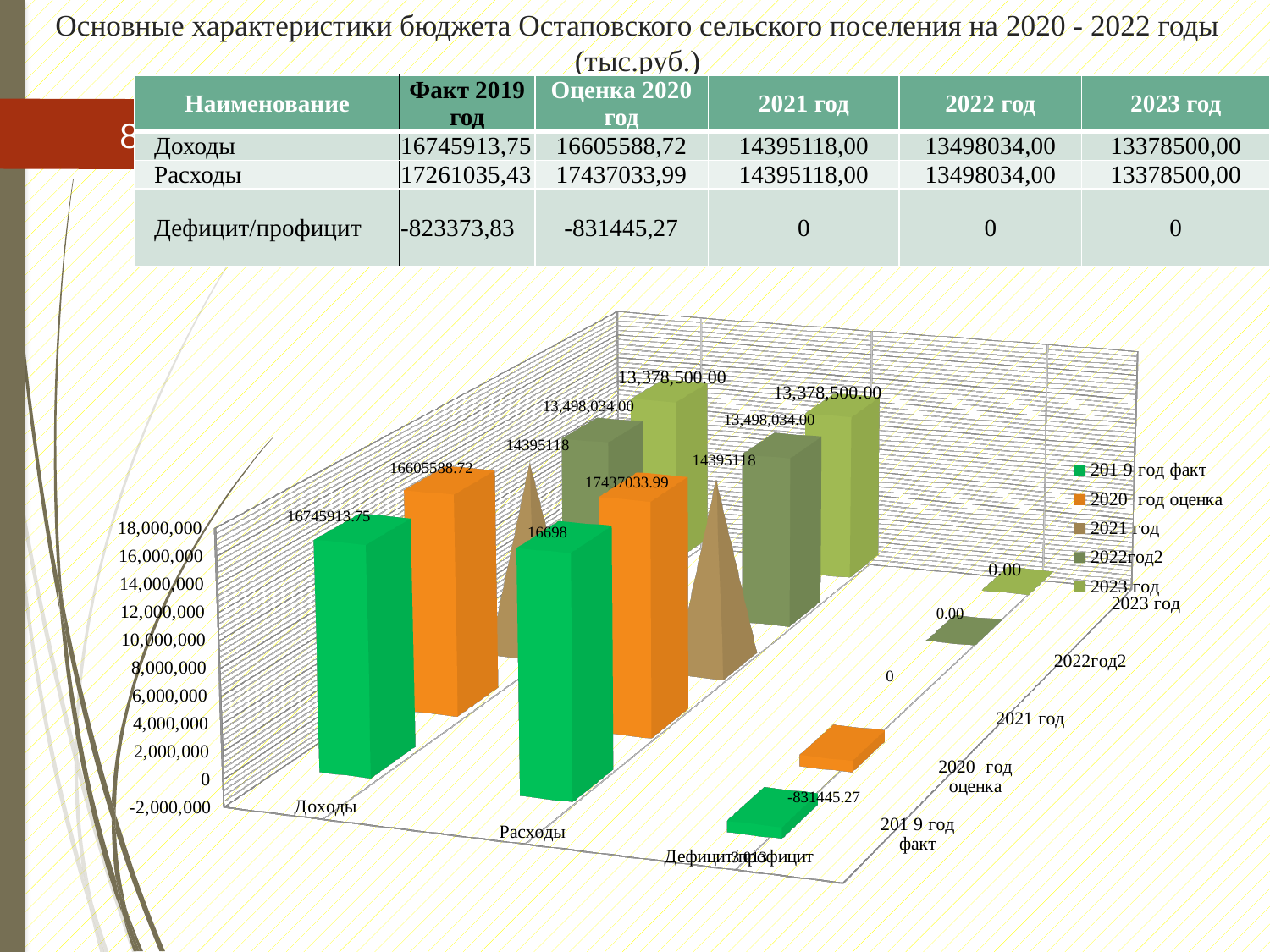
Do the Доходы values rise or fall from the 2019 год факт series to the 2023 год series? fall What is the value for Расходы in the 2020 год оценка series? 17437033.99 What is the value for Доходы in the 2020 год оценка series? 16605588.72 How many categories are shown along the x axis of the chart? 3 Which is larger for the 2020 год оценка series: Доходы or Расходы? Расходы How many series does the chart legend list? 5 What kind of chart is shown on the slide? bar chart What is the value for Доходы in the 2019 год факт series? 16745913.75 Is the value for Расходы in the 2022год2 series greater or less than 14,000,000? less What is the value for Дефицит/профицит in the 2020 год оценка series? -831445.27 Which series has the highest value for Доходы? 2019 год факт What is the value for Доходы in the 2023 год series? 13,378,500.00